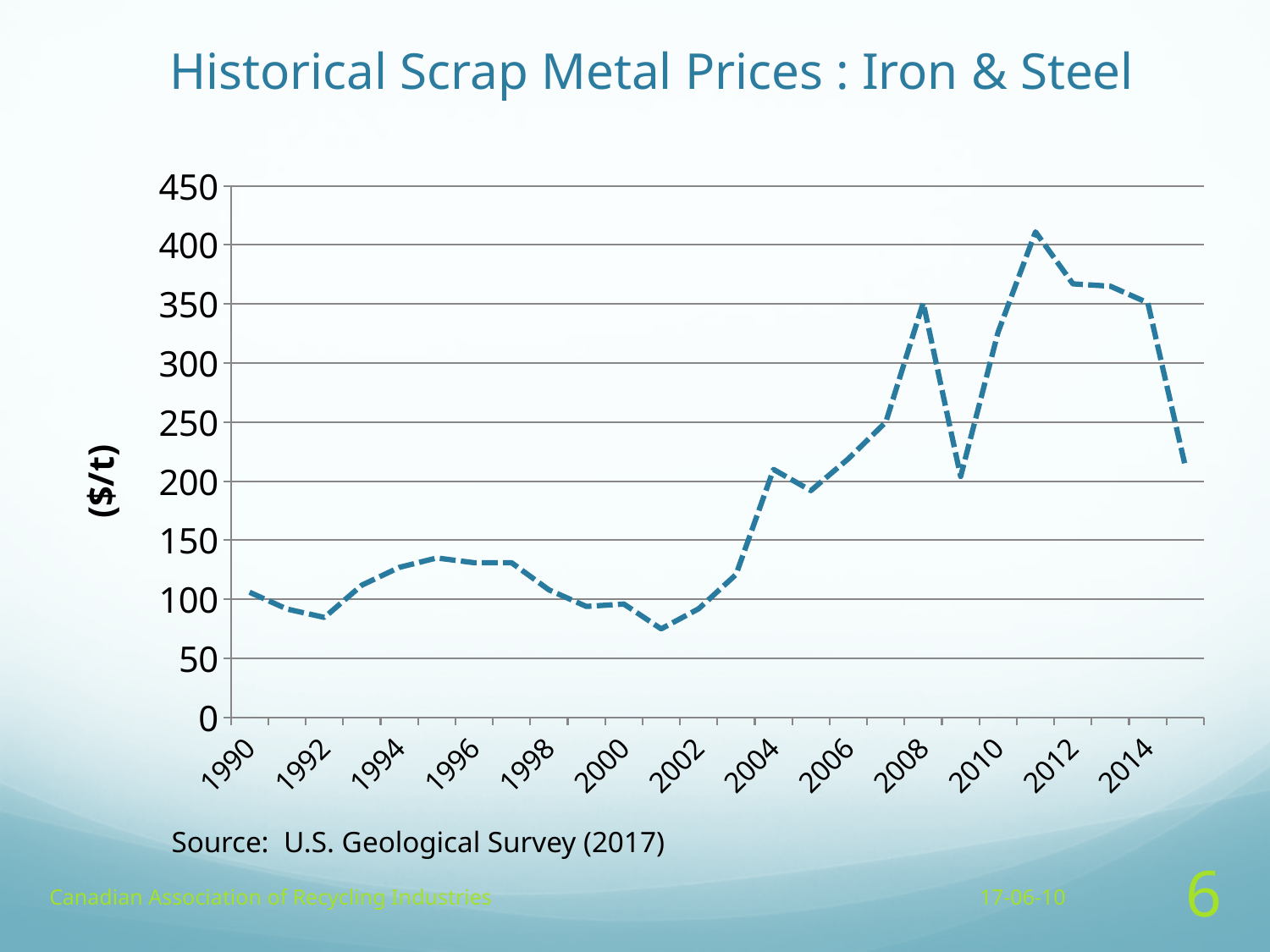
Does the line rise or fall between 2011 and 2015? fall Is the value for 2015 greater or less than 200? greater What kind of chart is shown on the slide? line chart What unit is shown on the vertical axis label? ($/t) Is the value for 2006 greater or less than 250? less Is the value for 2011 greater or less than 400? greater What is the title of the chart? Historical Scrap Metal Prices : Iron & Steel Does the line rise or fall between 2001 and 2008? rise In which year does the line reach its highest value? 2011 In which year does the line reach its lowest value? 2001